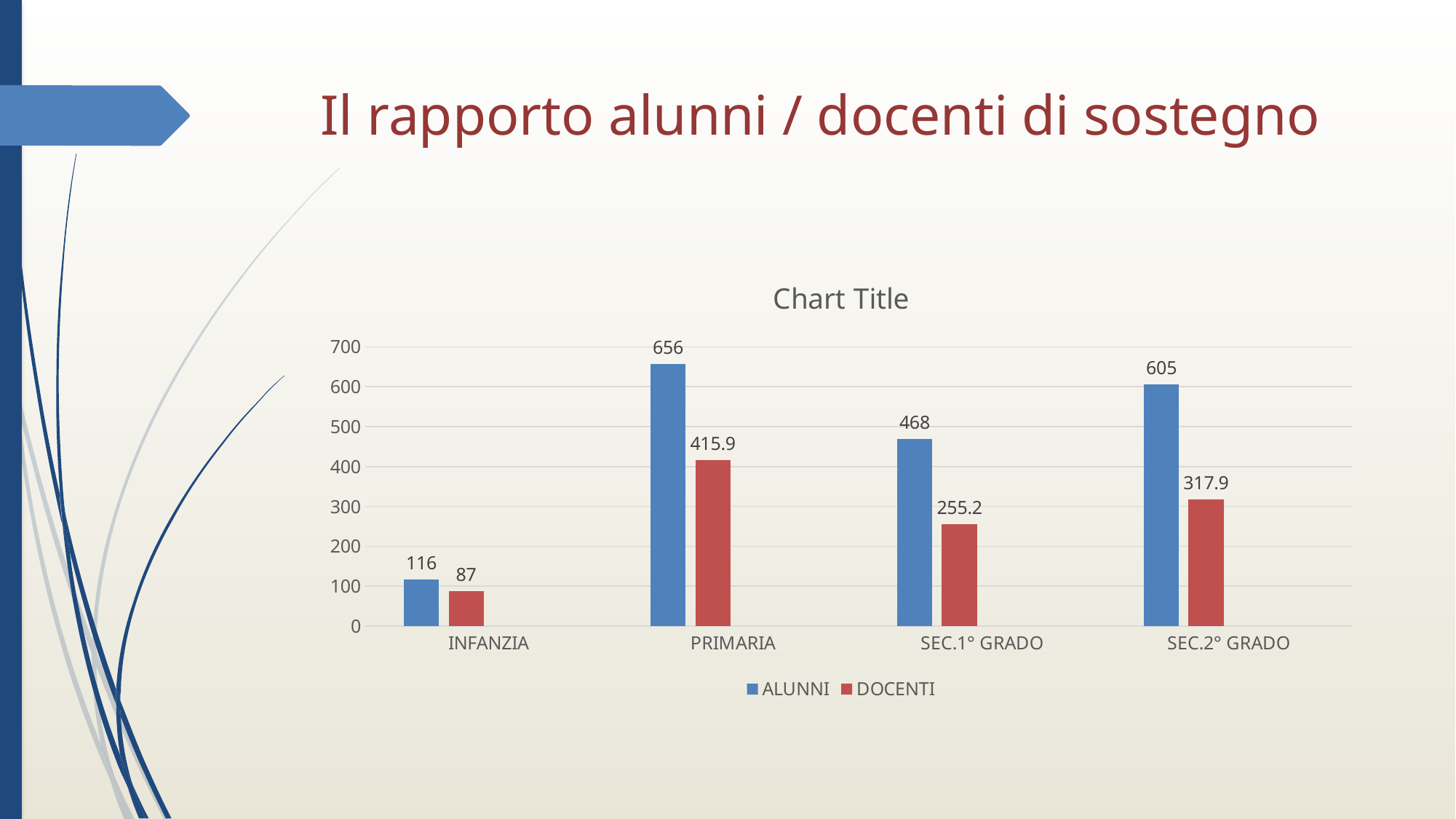
What colour are the DOCENTI bars? red How many categories are shown on the x axis? 4 What kind of chart is shown on the slide? bar chart What is the DOCENTI value for INFANZIA? 87 Is the ALUNNI value for SEC.1° GRADO greater or less than 400? greater How many series does the legend list? 2 Which is larger: the DOCENTI value for PRIMARIA or the DOCENTI value for SEC.2° GRADO? PRIMARIA Which category has the highest ALUNNI value? PRIMARIA What is the DOCENTI value for SEC.1° GRADO? 255.2 Which category has the lowest DOCENTI value? INFANZIA What is the ALUNNI value for PRIMARIA? 656 What is the difference between the ALUNNI and DOCENTI values for SEC.2° GRADO? 287.1